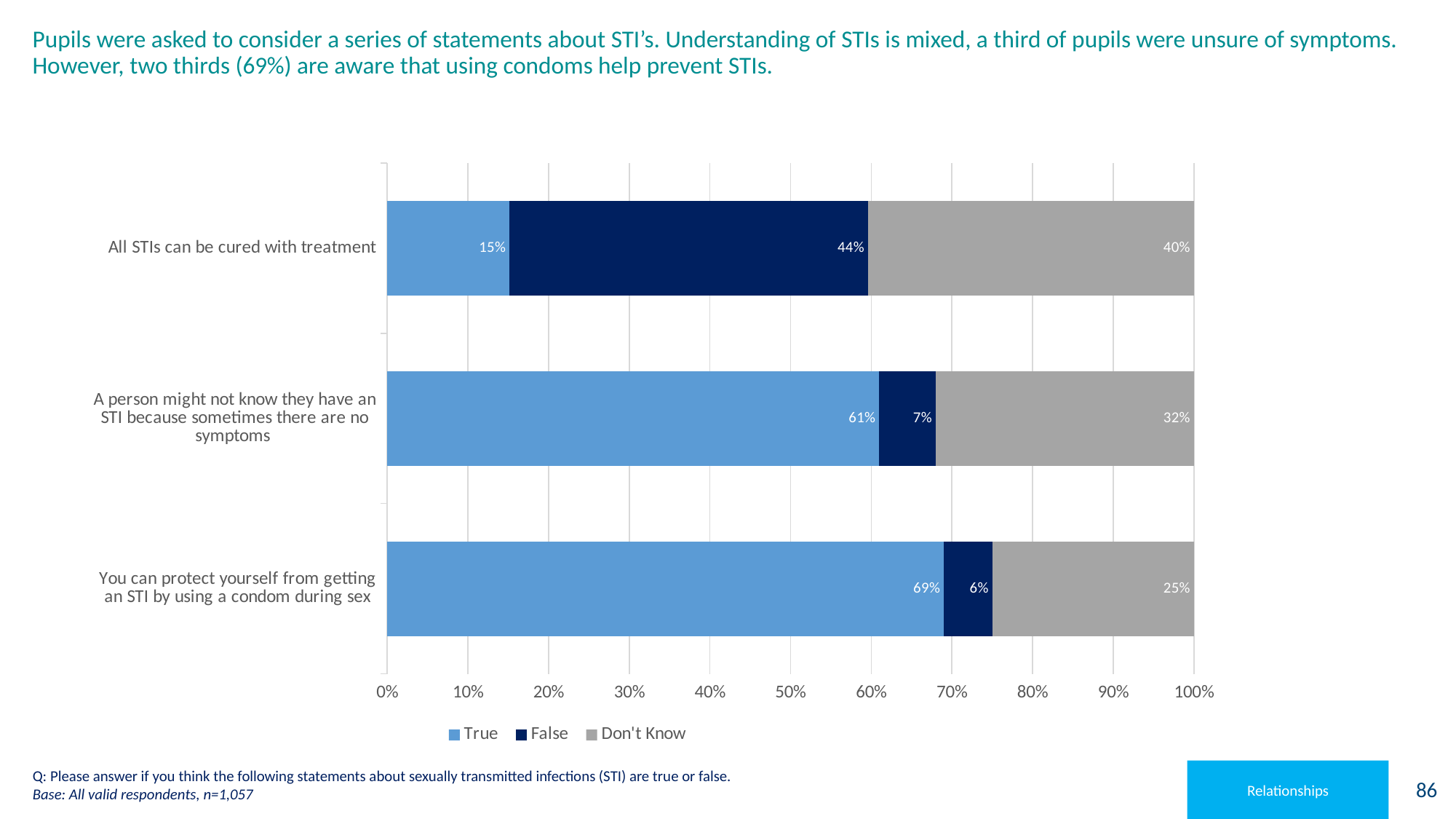
Which statement has the highest 'True' percentage? You can protect yourself from getting an STI by using a condom during sex What type of chart is shown on the slide? Stacked bar chart Which is larger for 'All STIs can be cured with treatment': the 'False' share or the 'Don't Know' share? False What colour represents the 'Don't Know' series in the chart? Grey What is the difference between the 'False' percentage and the 'True' percentage for 'All STIs can be cured with treatment'? 29% What percentage of pupils answered 'Don't Know' for the statement 'A person might not know they have an STI because sometimes there are no symptoms'? 32% Is the 'True' value for 'A person might not know they have an STI because sometimes there are no symptoms' greater or less than 50%? greater How many statements are shown in the chart? 3 What percentage of pupils said 'False' to the statement 'You can protect yourself from getting an STI by using a condom during sex'? 6% Which statement has the lowest 'Don't Know' percentage? You can protect yourself from getting an STI by using a condom during sex What percentage of pupils said 'True' to the statement 'All STIs can be cured with treatment'? 15% How many series does the legend list? 3